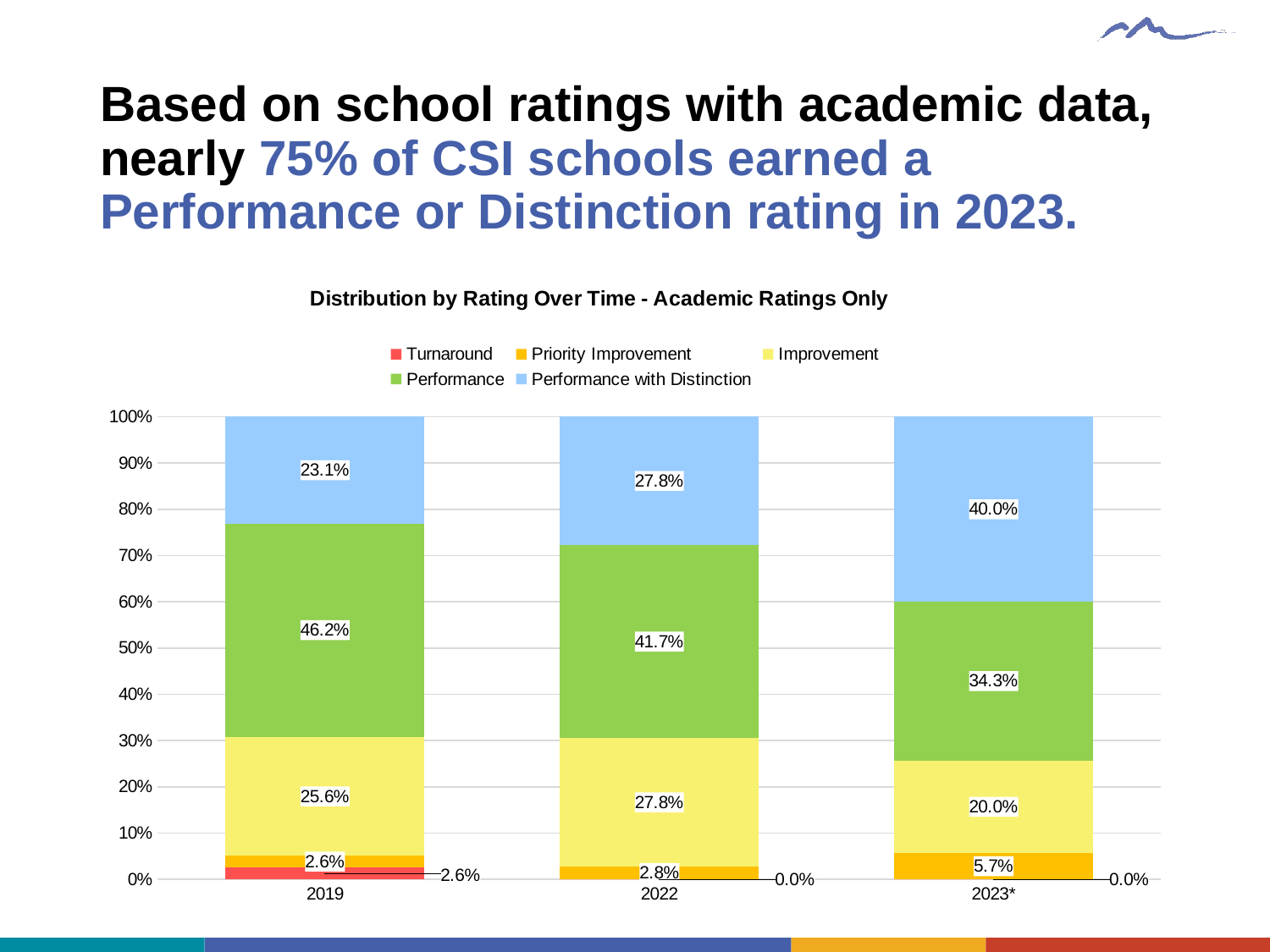
What is the difference between the Performance with Distinction values for 2023* and 2019? 16.9% What is the Improvement value for 2022? 27.8% What is the Turnaround value for 2022? 0.0% Which year has the lowest Performance value? 2023* What is the Performance with Distinction value for 2023*? 40.0% Which year has the highest Performance with Distinction value? 2023* What kind of chart is shown on the slide? Stacked bar chart What is the Performance value for 2019? 46.2% How many years are shown on the x axis? 3 Is the Performance value larger for 2019 or for 2022? 2019 What is the Priority Improvement value for 2023*? 5.7% How many series does the legend list? 5